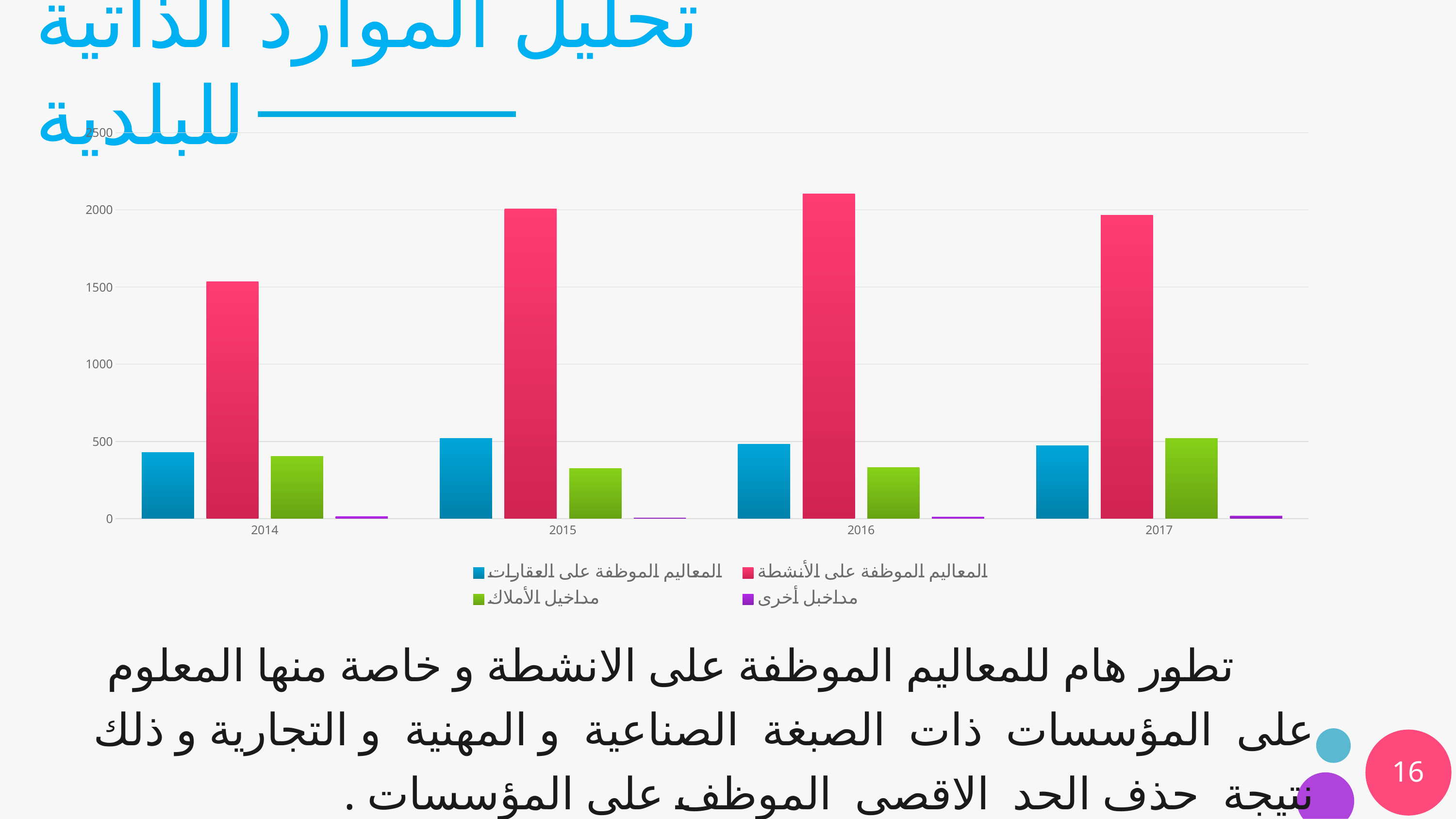
How many series does the chart legend list? 4 What colour are the bars for المعاليم الموظفة على الأنشطة? pink How many years are shown on the x axis of the chart? 4 Is the value for المعاليم الموظفة على الأنشطة in 2016 greater or less than 2000? greater Which series has the tallest bar in every year? المعاليم الموظفة على الأنشطة In which year is the value for مداخيل الأملاك highest? 2017 Is the value for مداخيل الأملاك in 2015 greater or less than 500? less Is the value for المعاليم الموظفة على العقارات in 2014 greater or less than 500? less What kind of chart is shown on the slide? bar chart In 2015, which is larger: المعاليم الموظفة على العقارات or مداخيل الأملاك? المعاليم الموظفة على العقارات Which series has the shortest bar in every year? مداخبل أخرى In which year is the value for المعاليم الموظفة على الأنشطة lowest? 2014